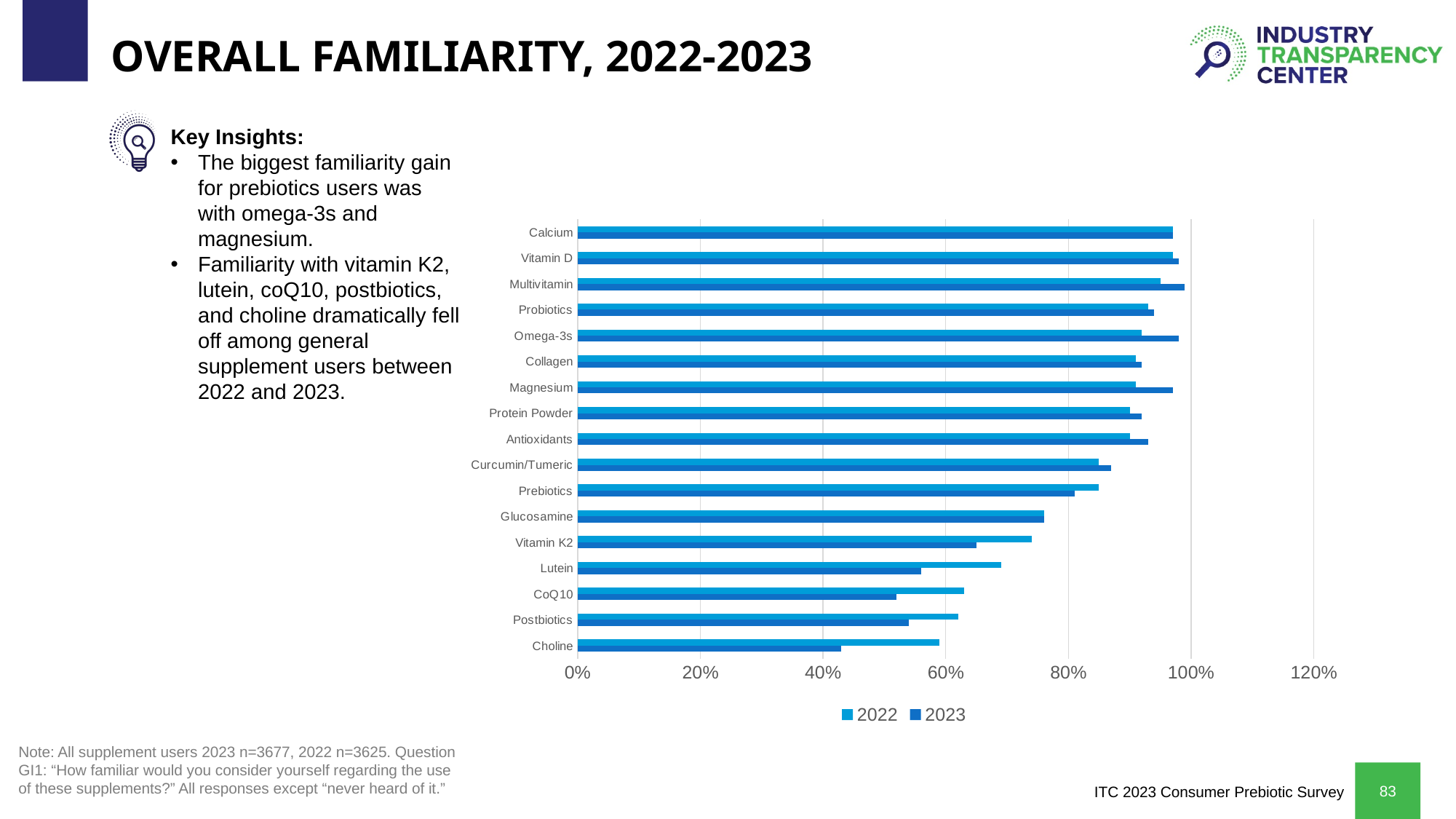
Is the 2023 value for Choline greater or less than 60%? less For Lutein, which year has the larger familiarity value, 2022 or 2023? 2022 For Vitamin K2, which year has the larger familiarity value, 2022 or 2023? 2022 How many supplement categories are listed on the chart? 17 For Omega-3s, which year has the larger familiarity value, 2022 or 2023? 2023 Which supplement has the lowest familiarity value for 2023? Choline Is the 2023 value for CoQ10 greater or less than 60%? less Is the 2022 value for Glucosamine greater or less than 60%? greater What are the two series named in the chart legend? 2022 and 2023 What kind of chart is shown on the slide? Bar chart How many series does the chart legend list? 2